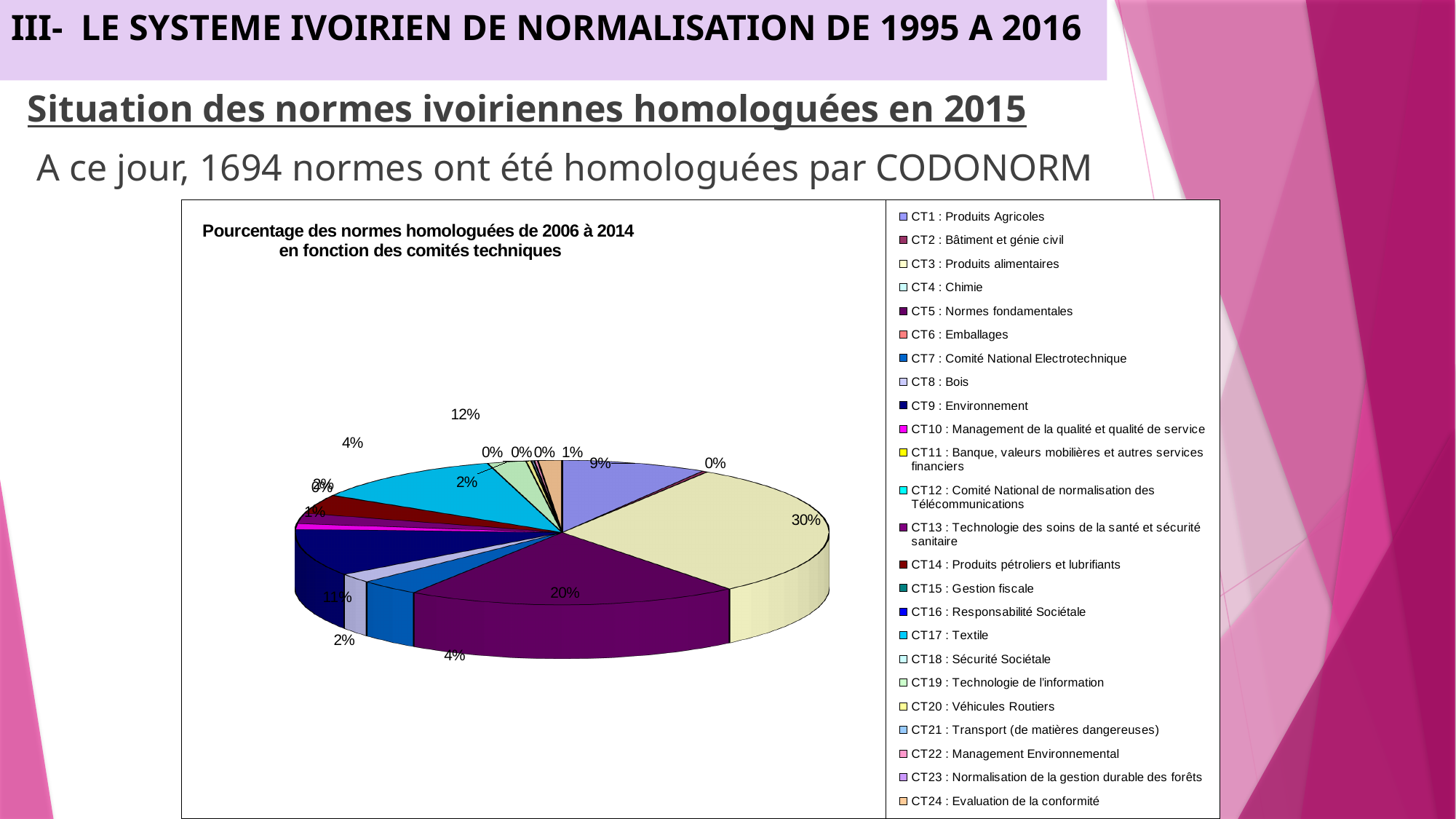
What share of the pie does CT1 : Produits Agricoles have? 9% What share of the pie does CT3 : Produits alimentaires have? 30% How many technical committees (CT) does the chart legend list? 24 What share of the pie does CT5 : Normes fondamentales have? 20% Which is larger, the share for CT3 : Produits alimentaires or the share for CT5 : Normes fondamentales? CT3 : Produits alimentaires What is the largest percentage shown on the pie chart? 30% What is the difference in percentage points between the share of CT3 : Produits alimentaires and the share of CT1 : Produits Agricoles? 21 percentage points What is the difference in percentage points between the 30% slice and the 20% slice? 10 percentage points Which technical committee has the largest share of the pie? CT3 : Produits alimentaires What is the title of the chart? Pourcentage des normes homologuées de 2006 à 2014 en fonction des comités techniques What kind of chart is shown on the slide? pie chart